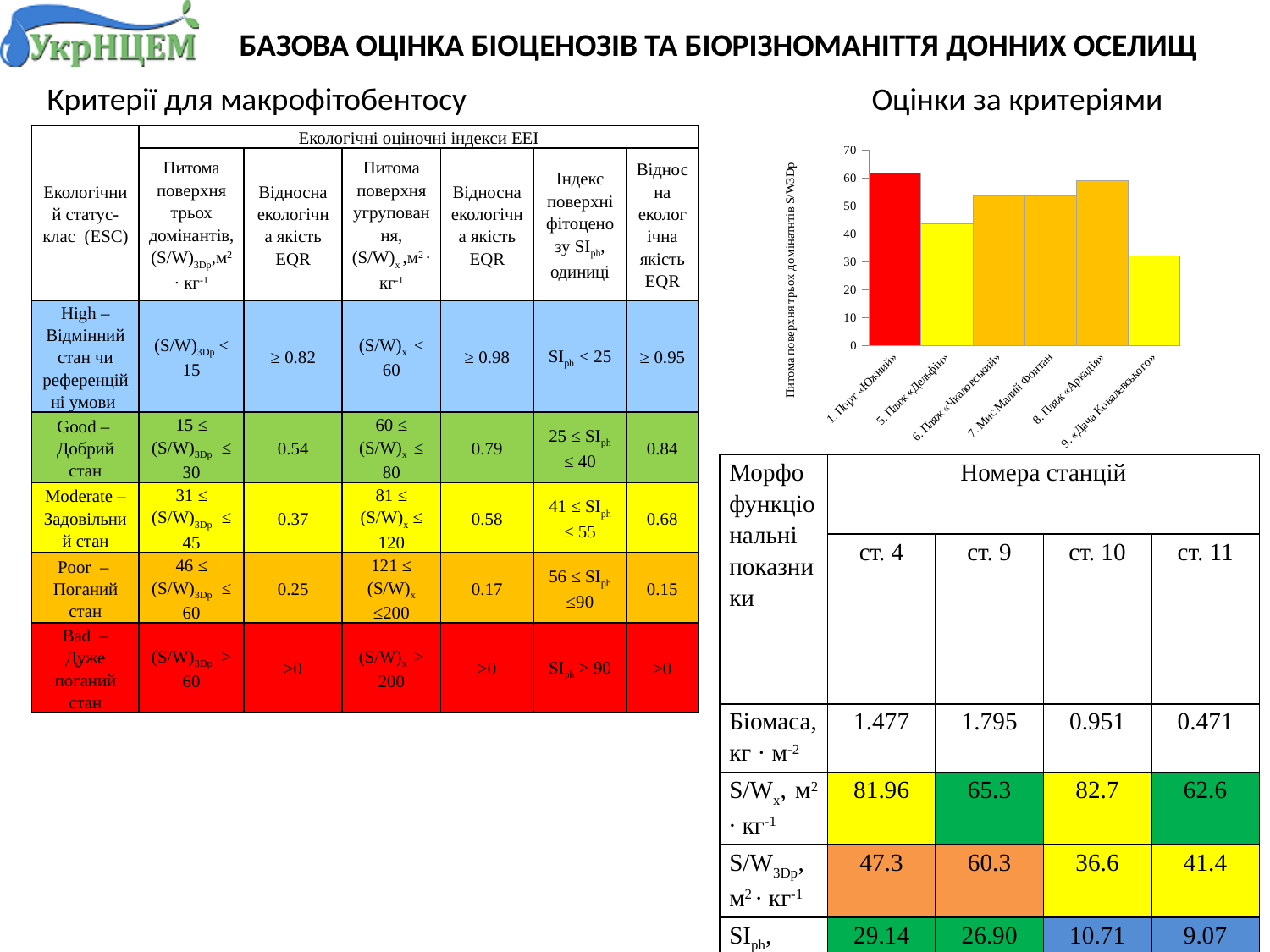
How many stations (bars) are plotted in the bar chart? 6 What kind of chart is shown on the slide? bar chart Which station has the lowest value in the bar chart? 9. «Дача Ковалевського» Is the value for 6. Пляж «Чкаловський» greater or less than 50? greater What colour is the bar for 1. Порт «Южний» in the bar chart? red Which is larger in the bar chart: the value for 1. Порт «Южний» or for 5. Пляж «Дельфін»? 1. Порт «Южний» Which is larger in the bar chart: the value for 5. Пляж «Дельфін» or for 9. «Дача Ковалевського»? 5. Пляж «Дельфін» Is the value for 9. «Дача Ковалевського» greater or less than 40? less Is the value for 8. Пляж «Аркадія» greater or less than 50? greater What is the title of the vertical axis of the bar chart? Питома поверхня трьох домінантів S/W3Dp